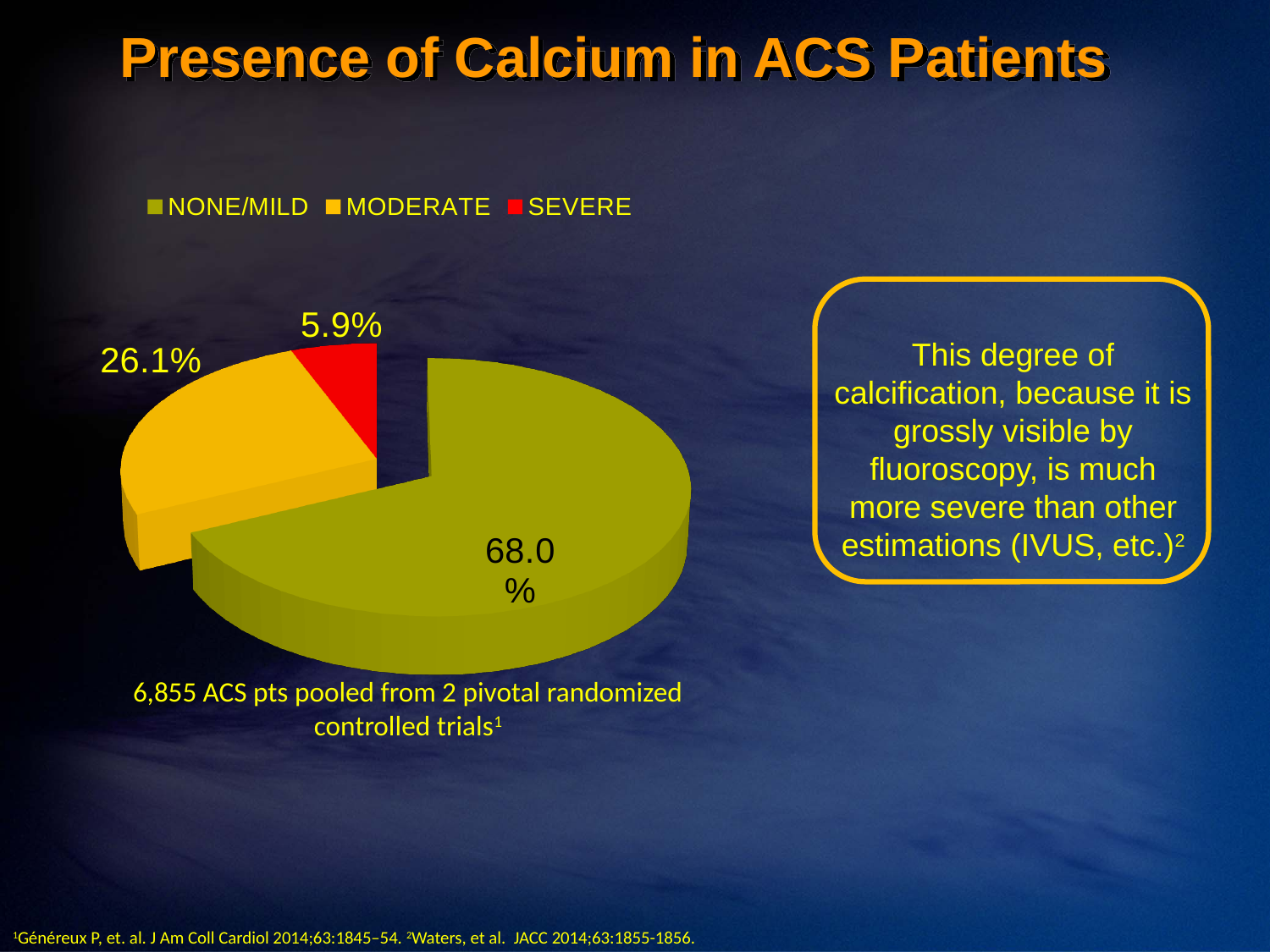
What is the difference in percentage points between the MODERATE and SEVERE slices? 20.2 Which category has the largest share of the pie? NONE/MILD What percentage of ACS patients had NONE/MILD calcium? 68.0% What kind of chart is shown on the slide? Pie chart How many categories does the pie chart show? 3 What is the difference in percentage points between the NONE/MILD and MODERATE slices? 41.9 Which is larger, the MODERATE slice or the SEVERE slice? MODERATE Which category has the smallest share of the pie? SEVERE What colour is the SEVERE slice in the pie chart? Red What percentage of ACS patients had SEVERE calcium? 5.9% What percentage of ACS patients had MODERATE calcium? 26.1% How many ACS patients were pooled for the data in the chart? 6,855